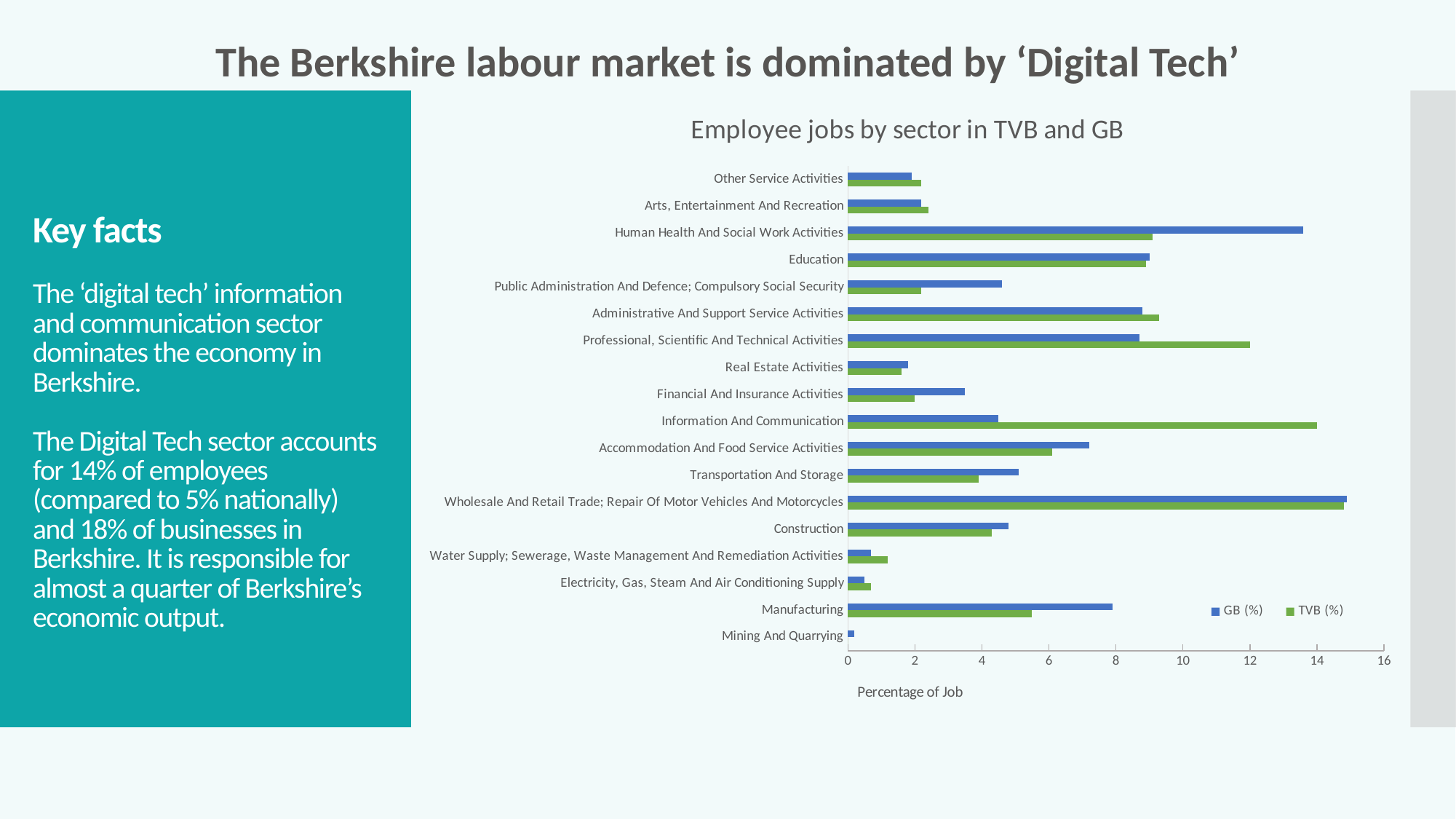
What is the title of the chart? Employee jobs by sector in TVB and GB How many series does the chart legend list? 2 Is the GB (%) value for Information And Communication greater or less than 6? less For Human Health And Social Work Activities, which is larger: the GB (%) value or the TVB (%) value? GB (%) For Manufacturing, which is larger: the GB (%) value or the TVB (%) value? GB (%) What type of chart is shown on the slide? Bar chart Which sector has the highest GB (%) value? Wholesale And Retail Trade; Repair Of Motor Vehicles And Motorcycles What is the label of the horizontal axis? Percentage of Job Which sector has the lowest GB (%) value? Mining And Quarrying Is the TVB (%) value for Information And Communication greater or less than 12? greater Is the TVB (%) value for Professional, Scientific And Technical Activities greater or less than 10? greater How many sectors (categories) are shown on the chart? 18